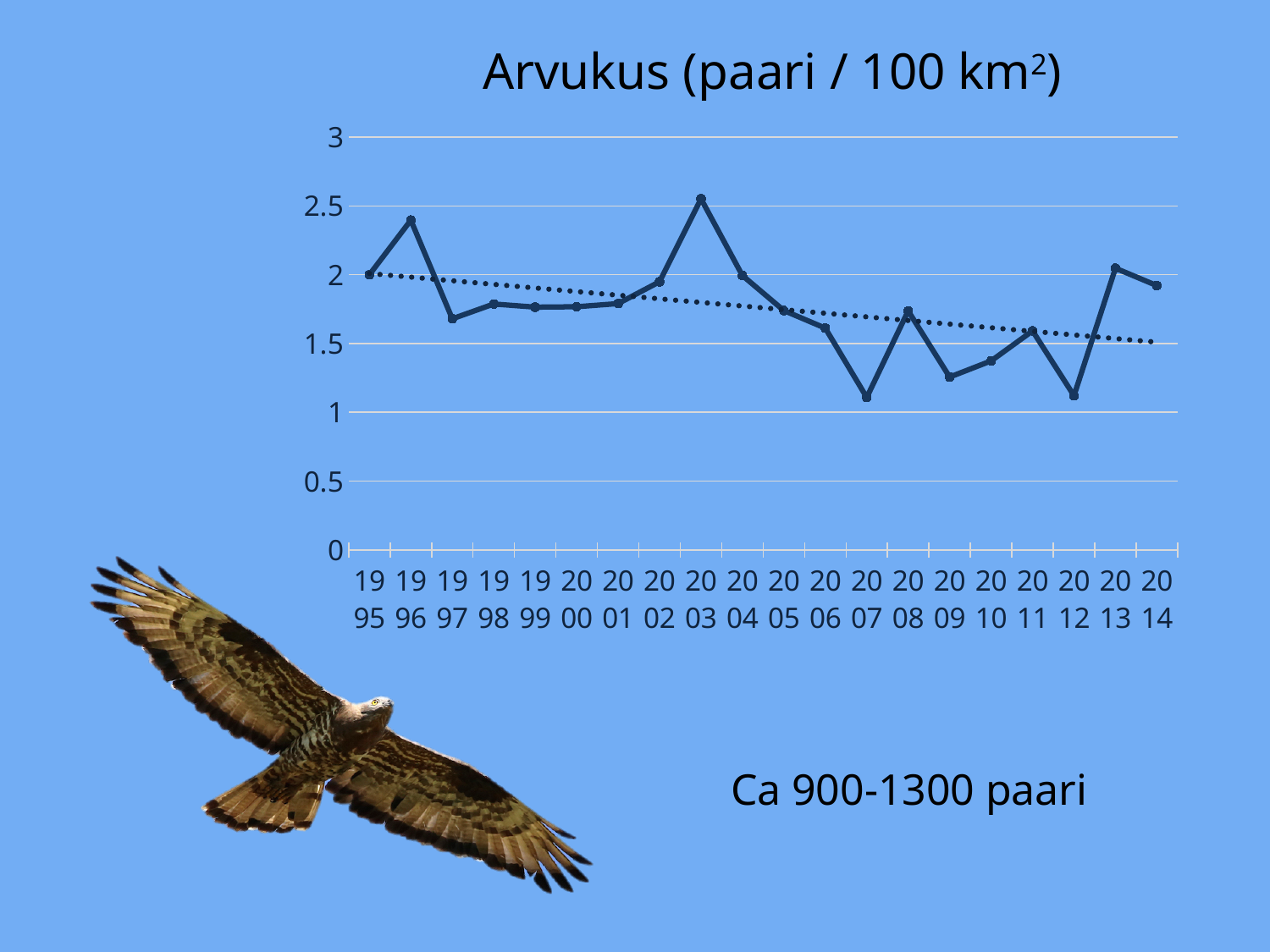
What is the title of the chart? Arvukus (paari / 100 km²) Is the value for 1996 greater or less than 2? greater According to the dotted trend line, do the values generally rise or fall from 1995 to 2014? fall Is the value for 2009 greater or less than 1.5? less Which year has the larger value, 2007 or 2008? 2008 How many years (data points) are plotted along the x axis? 20 Which year has the larger value, 2003 or 1996? 2003 Which year has the highest value on the chart? 2003 Is the value for 1997 greater or less than 2? less What kind of chart is shown on the slide? line chart